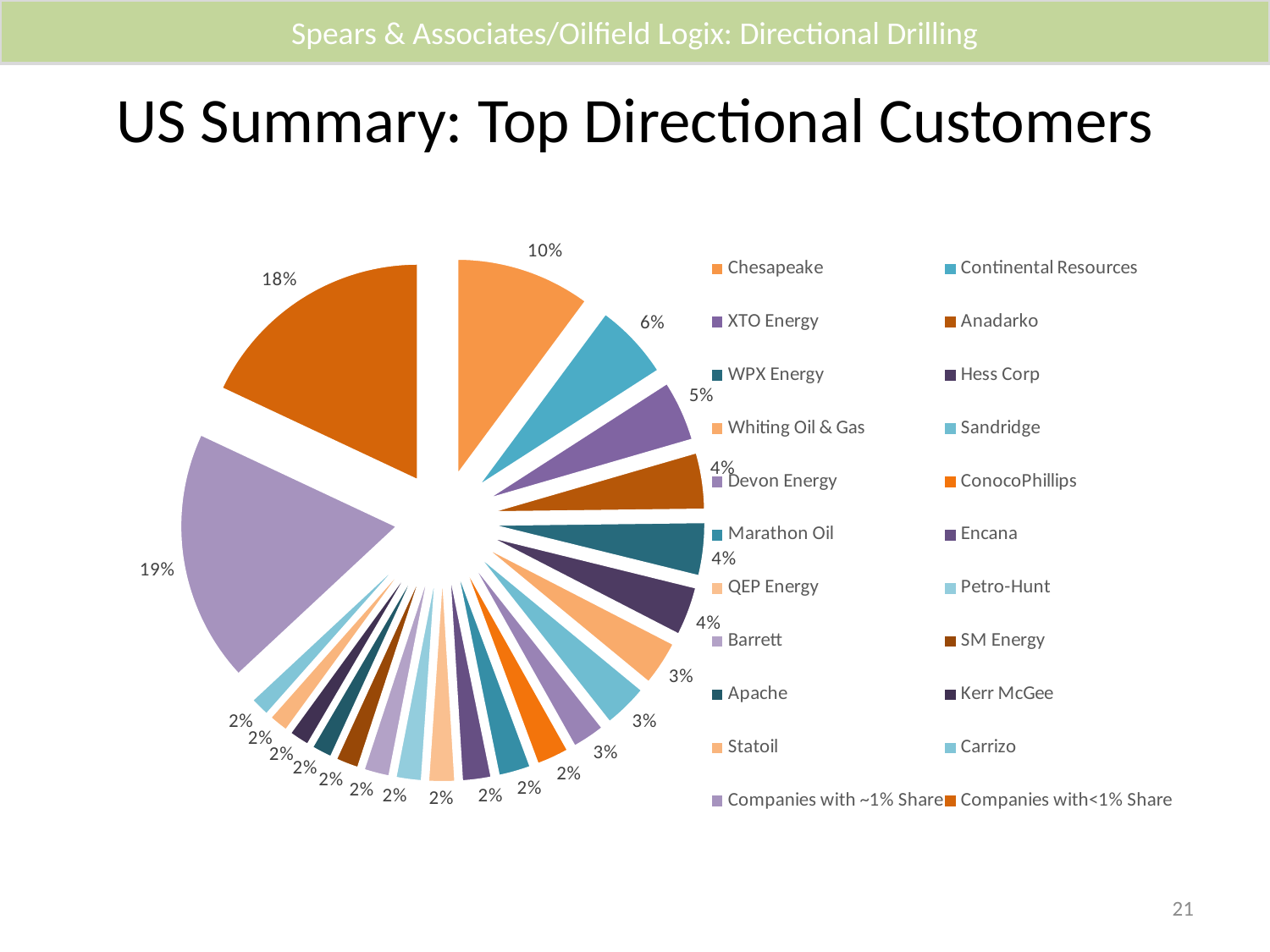
Which slice of the pie is the largest? Companies with ~1% Share How many entries does the chart legend list? 22 What kind of chart is shown on the slide? Pie chart What is the title of the chart on the slide? US Summary: Top Directional Customers What share of the pie does Continental Resources hold? 6% By how many percentage points does Chesapeake's share exceed Continental Resources' share? 4 percentage points What share of the pie is labelled for Companies with ~1% Share? 19% What share of the pie is labelled for Companies with <1% Share? 18% Which individually named company has the largest slice of the pie? Chesapeake Which has the larger share, Chesapeake or XTO Energy? Chesapeake